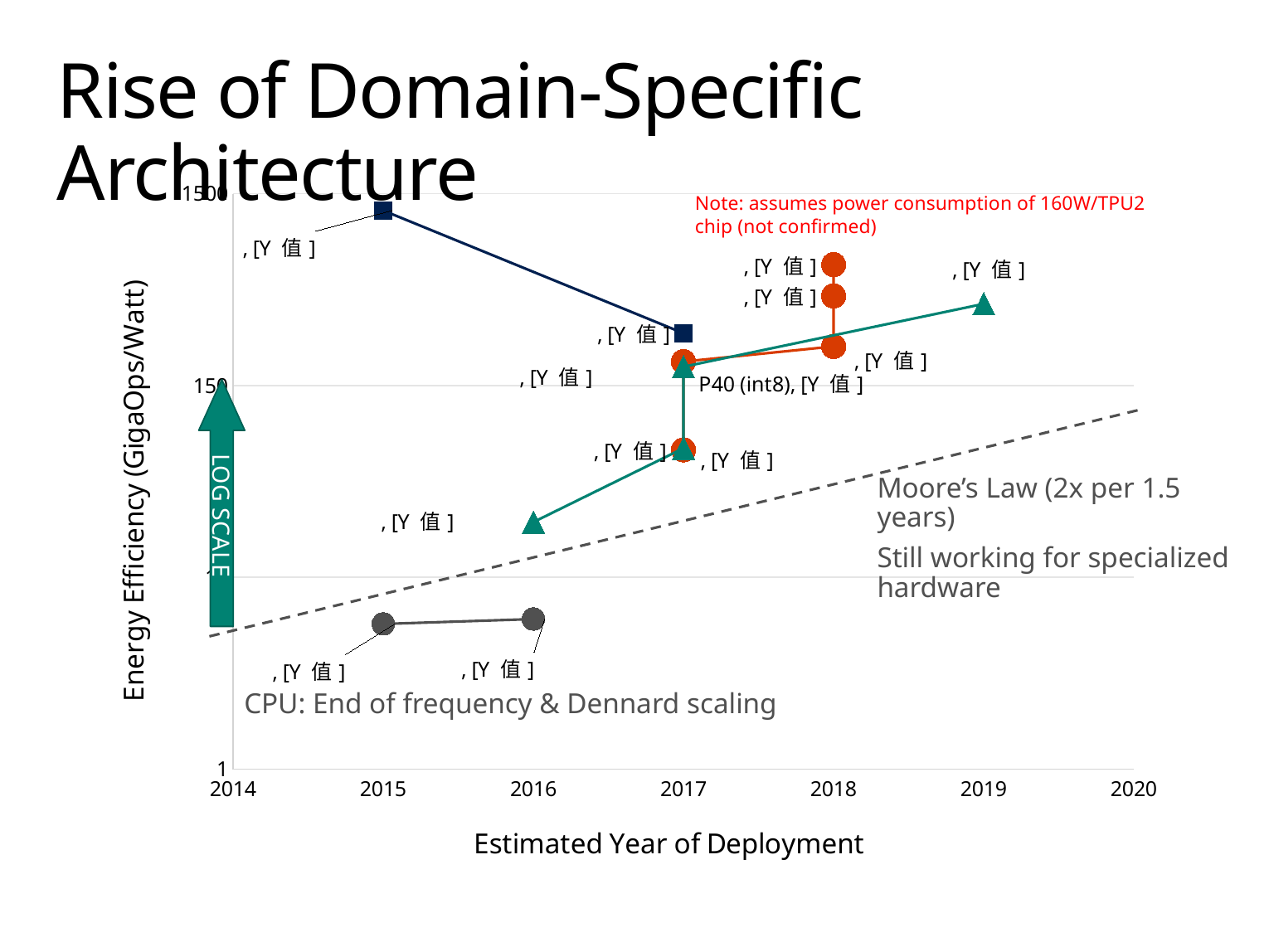
What is the title of the y axis of the chart? Energy Efficiency (GigaOps/Watt) Which is larger: the green triangle value at 2019 or the green triangle value at 2016? 2019 Is the value of the dark blue square point at 2017 greater or less than 150? greater How many gray circle points are plotted on the chart? 2 Is the value of the green triangle point at 2016 greater or less than 150? less How many year labels are shown on the x axis of the chart? 7 Is the value of the green triangle point at 2019 greater or less than 150? greater Do the values of the dark blue square series rise or fall from 2015 to 2017? fall Do the values of the green triangle series rise or fall from 2016 to 2019? rise What kind of chart is shown on the slide? scatter chart What is the title of the x axis of the chart? Estimated Year of Deployment